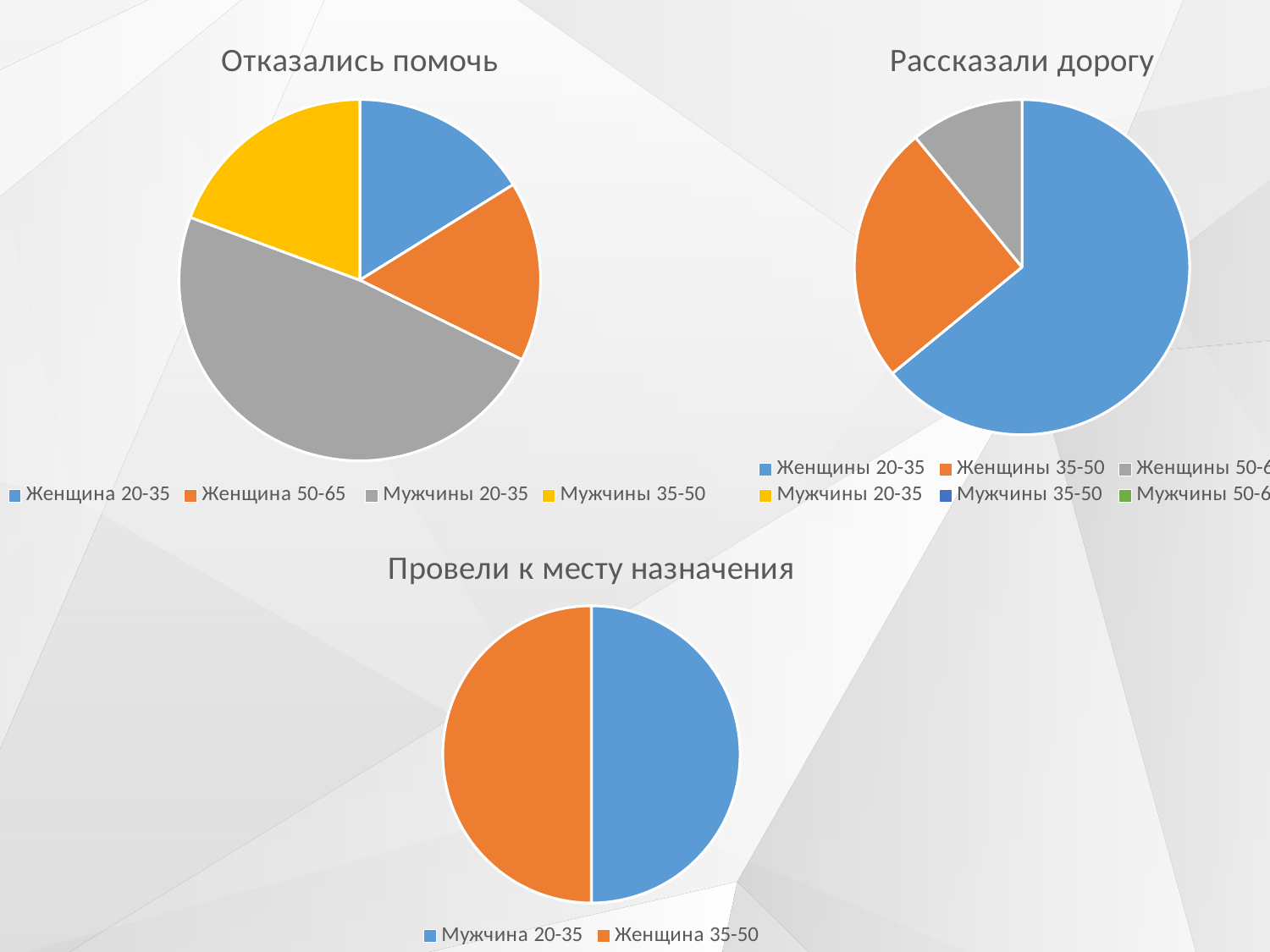
In the 'Отказались помочь' chart, which slice is larger: Мужчины 35-50 or Женщина 20-35? Мужчины 35-50 How many categories does the legend of the 'Отказались помочь' chart list? 4 What is the title of the chart at the bottom of the slide? Провели к месту назначения How many categories does the 'Провели к месту назначения' chart have? 2 In the 'Отказались помочь' chart, which category has the largest slice? Мужчины 20-35 What kind of chart is the 'Провели к месту назначения' chart? Pie chart What kind of chart is the 'Отказались помочь' chart? Pie chart In the 'Провели к месту назначения' chart, what colour represents Мужчина 20-35? Blue In the 'Отказались помочь' chart, which slice is larger: Мужчины 20-35 or Женщина 50-65? Мужчины 20-35 In the 'Рассказали дорогу' chart, which category has the largest slice? Женщины 20-35 In the 'Рассказали дорогу' chart, which slice is larger: Женщины 20-35 or Женщины 35-50? Женщины 20-35 How many slices are visible in the 'Рассказали дорогу' pie? 3